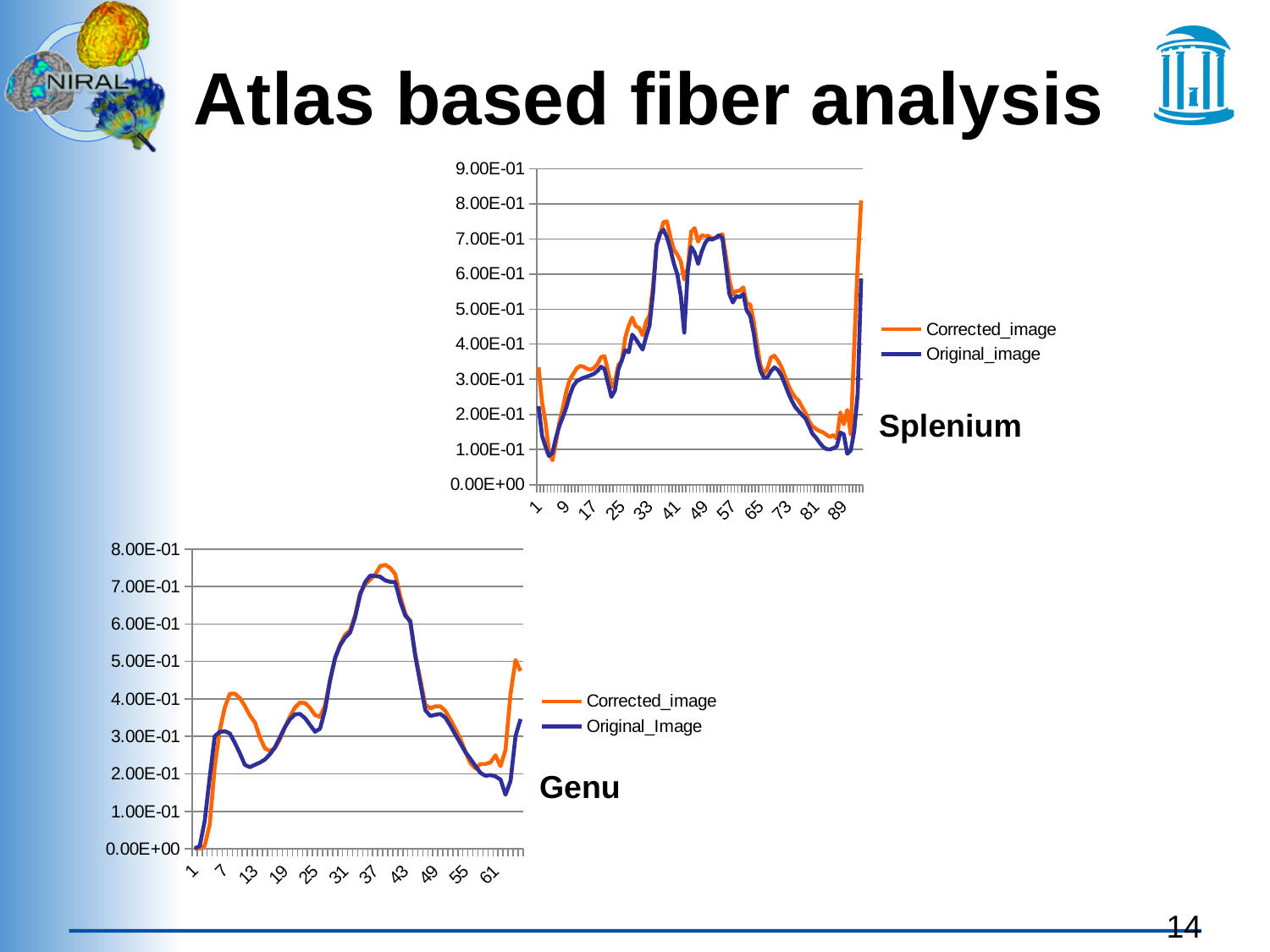
In the Genu chart, what are the two legend entries? Corrected_image and Original_Image In the Genu chart, does the Corrected_image series rise or fall between x = 37 and x = 55? fall In the Genu chart, is the peak value of the Corrected_image series greater or less than 7.00E-01? greater In the Genu chart, does the Original_Image series rise or fall between x = 1 and x = 7? rise How many series does the legend of the Genu chart list? 2 In the Splenium chart, is the value of Original_image at x = 1 greater or less than 1.00E-01? greater In the Splenium chart, is the peak value of the Corrected_image series greater or less than 6.00E-01? greater In the Splenium chart, which series is drawn in orange? Corrected_image What kind of chart is the Splenium chart? line chart In the Genu chart, at the last point on the x axis, which series has the higher value, Corrected_image or Original_Image? Corrected_image In the Splenium chart, at the last point on the x axis, which series has the higher value, Corrected_image or Original_image? Corrected_image